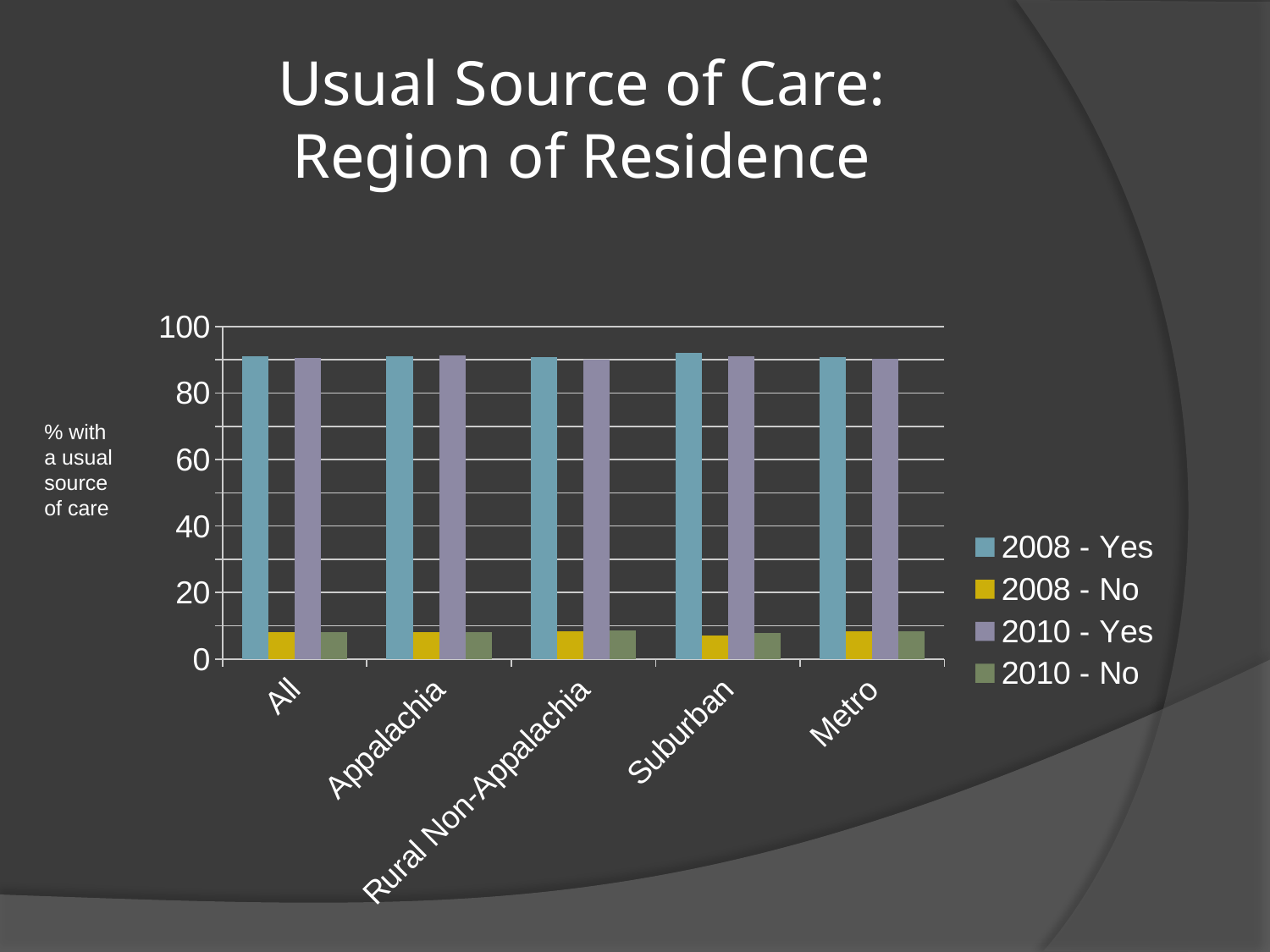
For Suburban, which is larger: the 2010 - No value or the 2010 - Yes value? 2010 - Yes Is the 2008 - Yes value for Appalachia greater or less than 80? greater How many region categories are shown on the x axis? 5 What does the y axis measure according to its label? % with a usual source of care For the All category, which is larger: the 2008 - Yes value or the 2008 - No value? 2008 - Yes Is the 2008 - No value for Rural Non-Appalachia greater or less than 20? less Is the 2010 - No value for Metro greater or less than 20? less How many series does the legend list? 4 What kind of chart is shown on the slide? bar chart What is the title of the chart? Usual Source of Care: Region of Residence